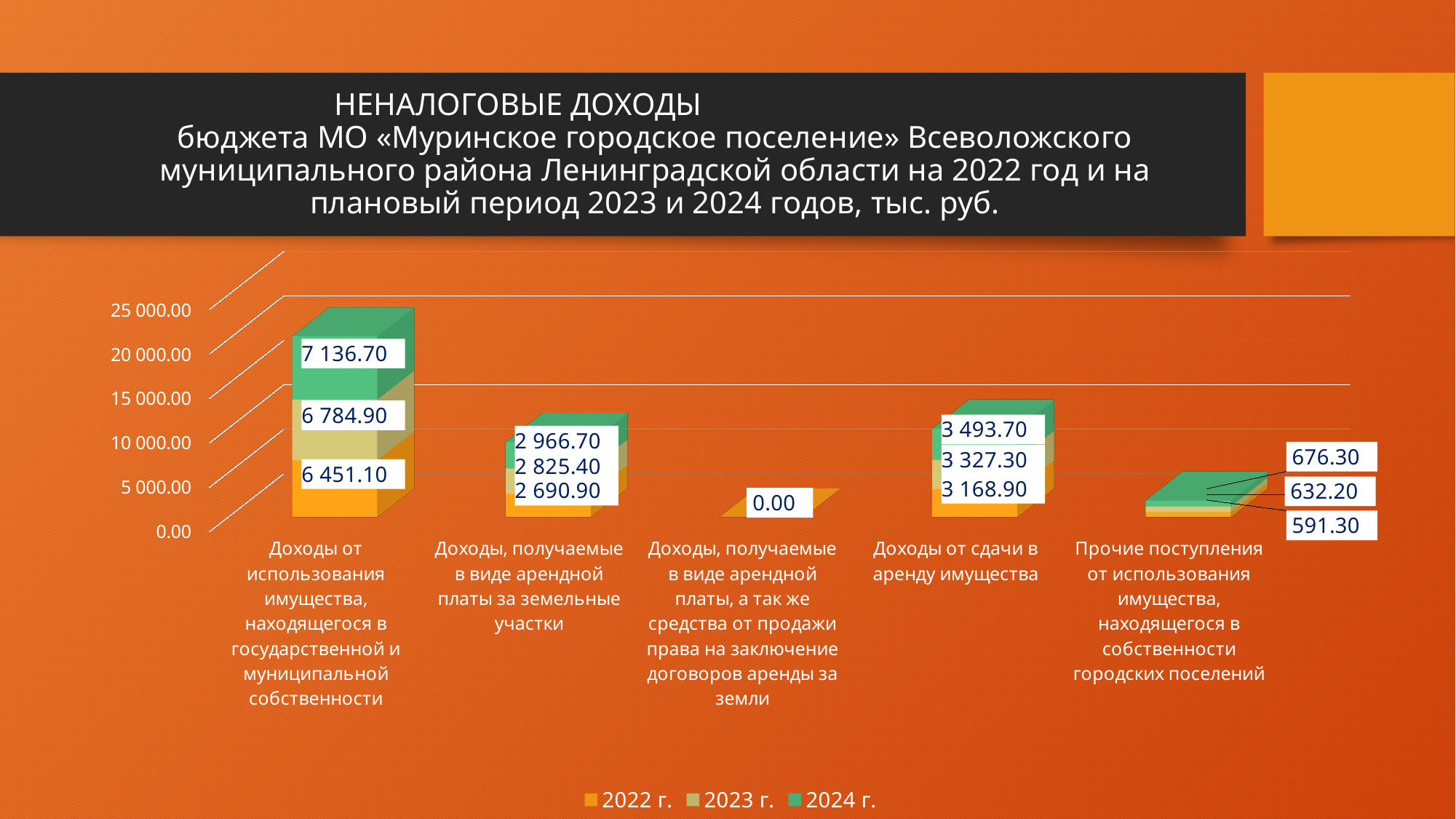
What is the difference between the 2024 г. and 2022 г. values for «Доходы от сдачи в аренду имущества»? 324.80 What is the 2024 г. value for «Доходы от использования имущества, находящегося в государственной и муниципальной собственности»? 7 136.70 What is the 2022 г. value for «Прочие поступления от использования имущества, находящегося в собственности городских поселений»? 591.30 What kind of chart is shown on the slide? Stacked bar chart How many series does the legend list? 3 Which category has the lowest value, shown as 0.00? Доходы, получаемые в виде арендной платы, а так же средства от продажи права на заключение договоров аренды за земли What is the total of the stacked bar for «Прочие поступления от использования имущества, находящегося в собственности городских поселений»? 1 899.80 What is the 2022 г. value for «Доходы, получаемые в виде арендной платы за земельные участки»? 2 690.90 Which category has the highest total across all three years? Доходы от использования имущества, находящегося в государственной и муниципальной собственности Which is larger: the 2023 г. value for «Доходы, получаемые в виде арендной платы за земельные участки» or the 2023 г. value for «Доходы от сдачи в аренду имущества»? Доходы от сдачи в аренду имущества What is the 2023 г. value for «Доходы от сдачи в аренду имущества»? 3 327.30 How many categories are shown on the x axis? 5